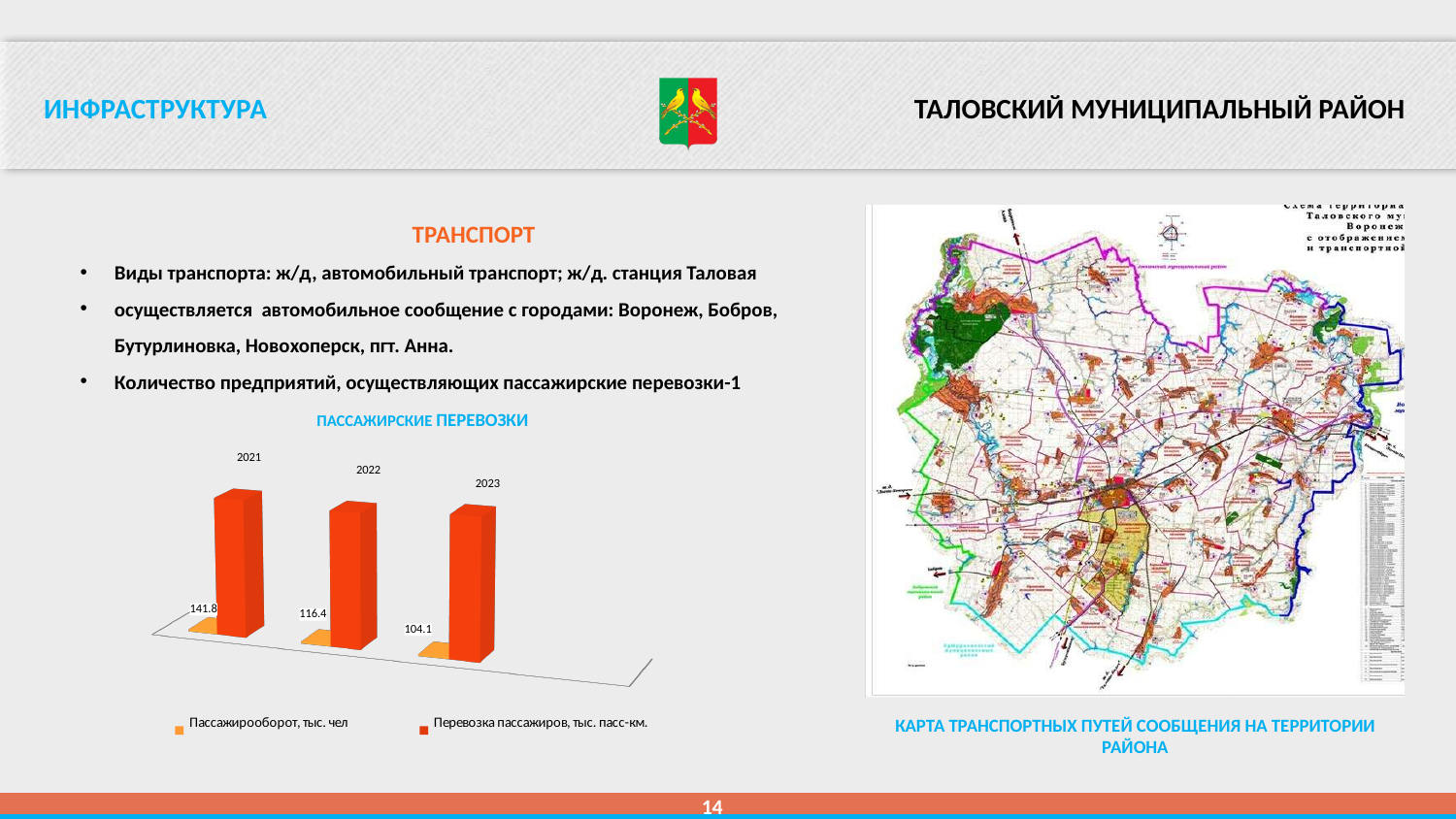
Which year has the highest labelled value on the chart? 2021 What data label is shown for 2023 on the chart? 104.1 What is the difference between the labelled values for 2021 and 2023? 37.7 How many years (categories) are shown on the chart? 3 What is the title of the chart on the slide? ПАССАЖИРСКИЕ ПЕРЕВОЗКИ What data label is shown for 2021 on the chart? 141.8 Which legend entry is shown in red on the chart? Перевозка пассажиров, тыс. пасс-км Which year has the lowest labelled value on the chart? 2023 How many series does the chart legend list? 2 What data label is shown for 2022 on the chart? 116.4 What kind of chart is shown under the heading ПАССАЖИРСКИЕ ПЕРЕВОЗКИ? bar chart Do the labelled values on the chart rise or fall from 2021 to 2023? fall